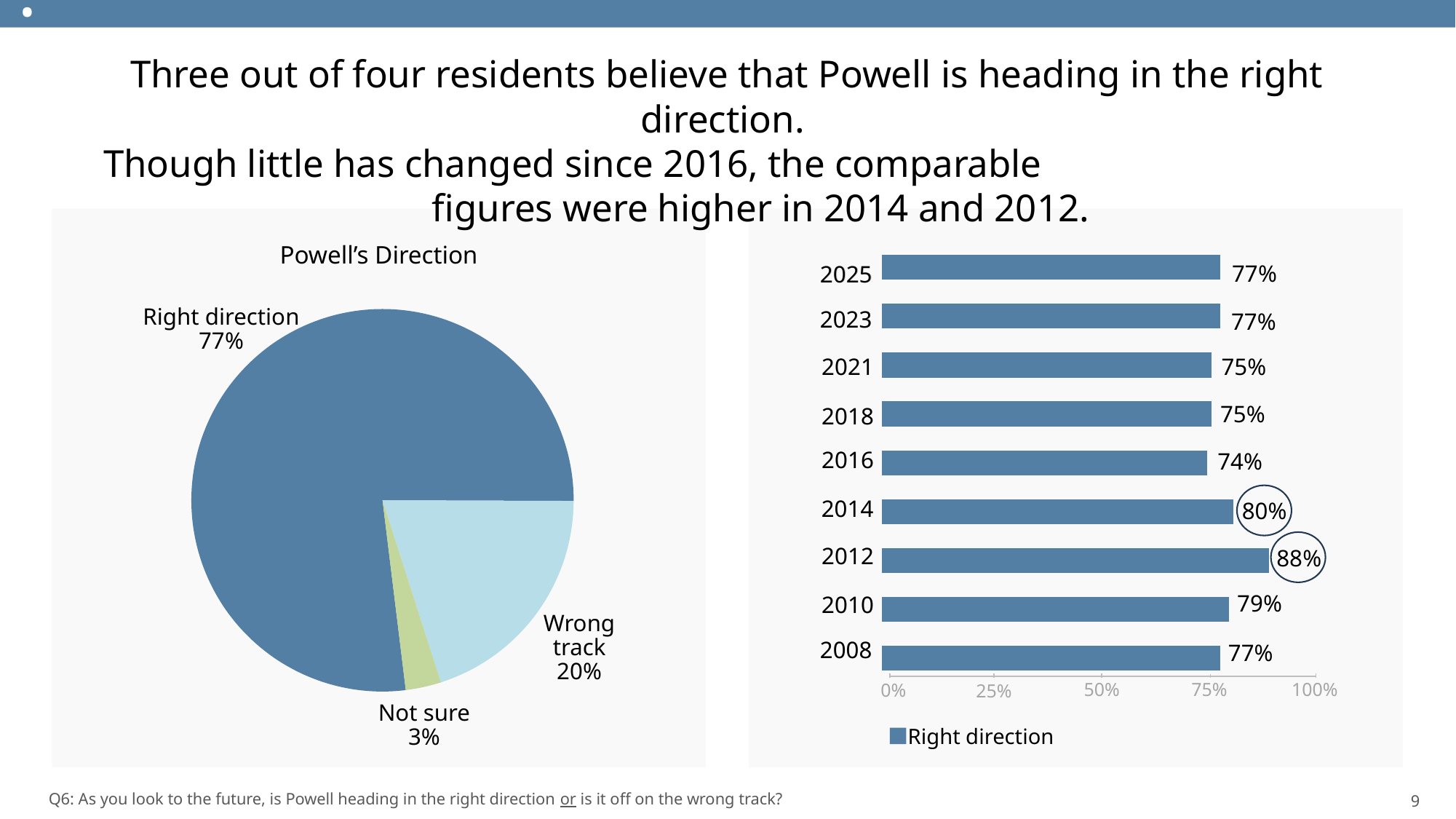
In the bar chart on the right, what was the 'Right direction' value in 2016? 74% How many slices does the 'Powell's Direction' pie chart have? 3 In the bar chart on the right, how many years are shown? 9 In the bar chart on the right, which year has the highest 'Right direction' value? 2012 In the bar chart on the right, what was the 'Right direction' value in 2012? 88% In the 'Powell's Direction' pie chart, what is the difference between the 'Right direction' and 'Wrong track' shares? 57 percentage points In the bar chart on the right, what is the difference between the 2012 and 2025 'Right direction' values? 11 percentage points In the 'Powell's Direction' pie chart, what share of residents say Powell is heading in the right direction? 77% In the bar chart on the right, which year has the lowest 'Right direction' value? 2016 In the 'Powell's Direction' pie chart, what percentage of residents are not sure? 3% In the 'Powell's Direction' pie chart, what percentage of residents say Powell is on the wrong track? 20% In the 'Powell's Direction' pie chart, which slice is the smallest? Not sure